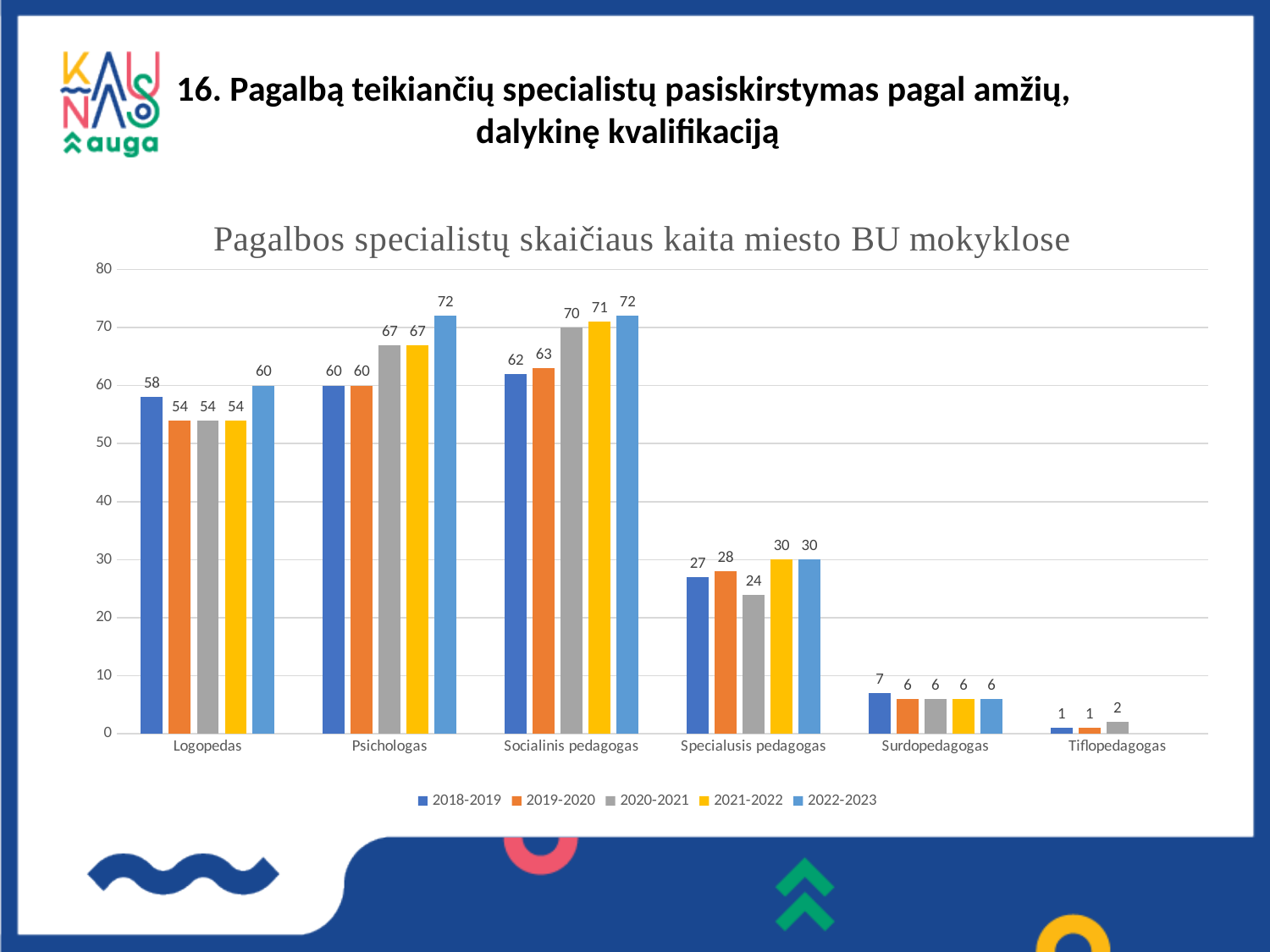
What is the value for Logopedas in 2022-2023? 60 In 2018-2019, which is larger: Logopedas or Socialinis pedagogas? Socialinis pedagogas How many categories are shown on the x axis? 6 Which category has the lowest value in the 2018-2019 series? Tiflopedagogas What is the difference between the 2022-2023 and 2018-2019 values for Socialinis pedagogas? 10 For Logopedas, which series has the highest value? 2022-2023 What kind of chart is shown on the slide? Bar chart What is the value for Psichologas in 2020-2021? 67 What is the value for Specialusis pedagogas in 2020-2021? 24 How many series does the legend list? 5 What is the difference between the 2022-2023 and 2019-2020 values for Psichologas? 12 What is the value for Surdopedagogas in 2018-2019? 7